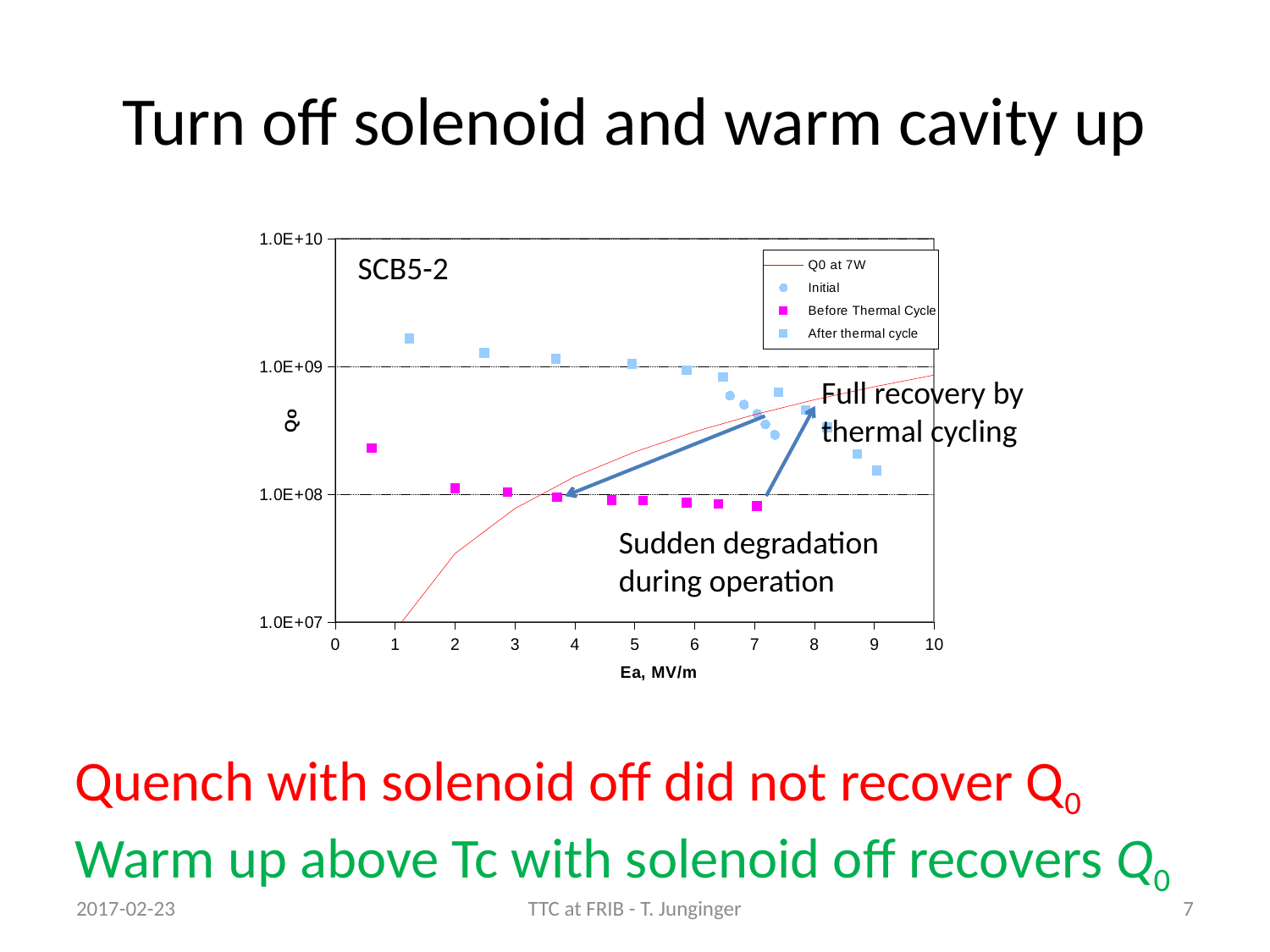
Is the 'Before Thermal Cycle' value at Ea = 5 MV/m greater or less than 1.0E+08? less Do the 'Before Thermal Cycle' values rise or fall as Ea increases? fall At Ea = 5 MV/m, which series has the larger Qo: 'Before Thermal Cycle' or 'After thermal cycle'? After thermal cycle What kind of chart is shown on the slide? scatter chart Do the 'After thermal cycle' values rise or fall as Ea increases? fall Is the 'After thermal cycle' value at Ea = 5 MV/m greater or less than 1.0E+08? greater Is the 'After thermal cycle' value at Ea = 2.5 MV/m greater or less than 1.0E+09? greater What cavity label is printed inside the chart area? SCB5-2 How many 'Before Thermal Cycle' data points are plotted? 9 What is the label on the x axis of the chart? Ea, MV/m How many series does the chart legend list? 4